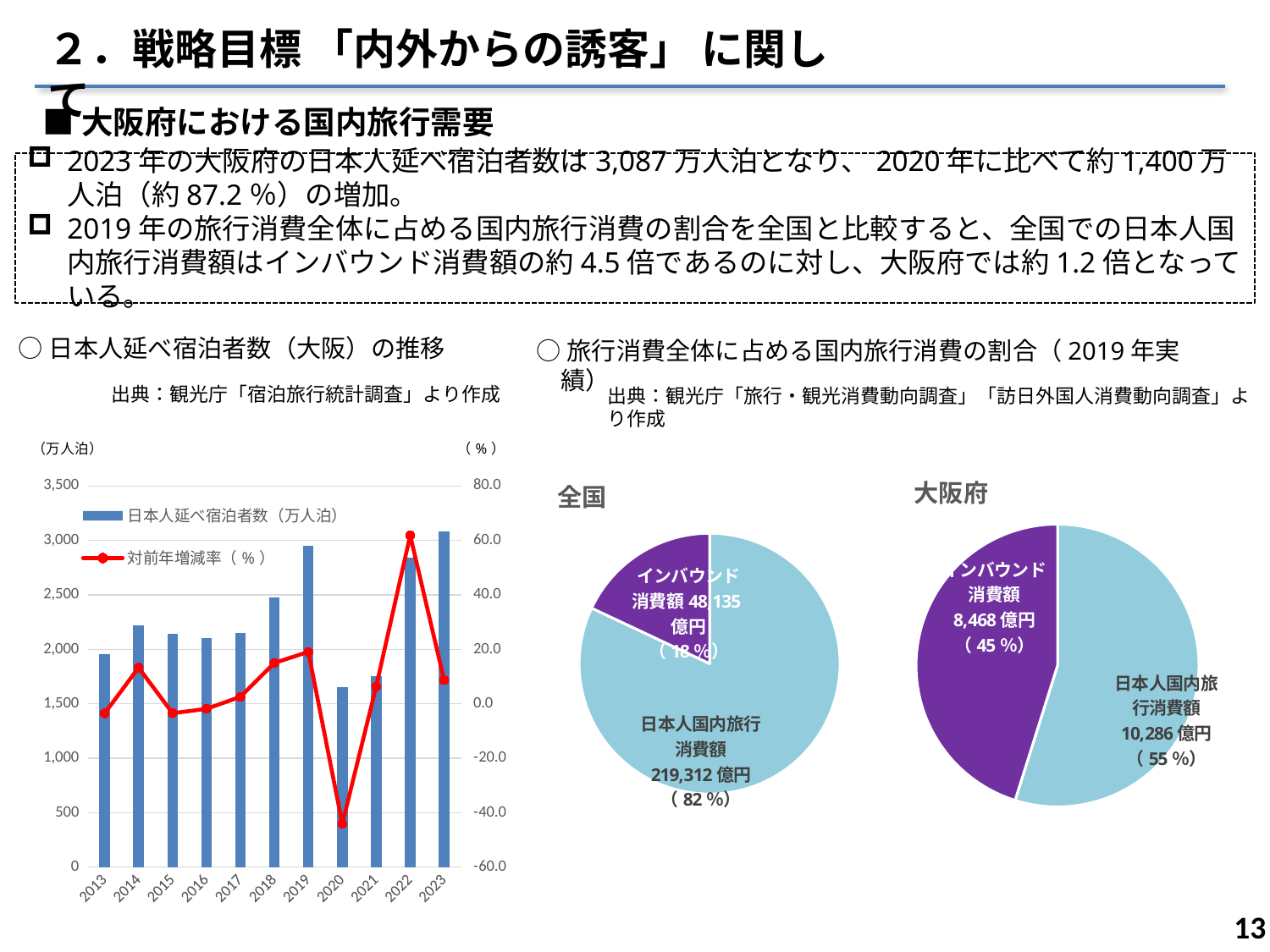
In the left chart (日本人延べ宿泊者数（大阪）の推移), is the 対前年増減率 value for 2020 greater or less than -20.0%? less What kind of chart is the left chart (日本人延べ宿泊者数（大阪）の推移)? Combined bar and line chart In the 全国 pie chart, what share does インバウンド消費額 have? 18% In the left chart (日本人延べ宿泊者数（大阪）の推移), which year has the lowest bar for 日本人延べ宿泊者数? 2020 In the left chart (日本人延べ宿泊者数（大阪）の推移), how many years are shown on the x axis? 11 In the left chart (日本人延べ宿泊者数（大阪）の推移), is the bar for 2020 greater or less than 2,000 万人泊? less In the 大阪府 pie chart, what is the difference between 日本人国内旅行消費額 and インバウンド消費額? 1,818億円 In the left chart (日本人延べ宿泊者数（大阪）の推移), how many series does the legend list? 2 In the left chart (日本人延べ宿泊者数（大阪）の推移), is the 対前年増減率 value for 2022 greater or less than 40.0%? greater In the 全国 pie chart, what is the value of 日本人国内旅行消費額? 219,312億円 In the 大阪府 pie chart, what is the value of インバウンド消費額? 8,468億円